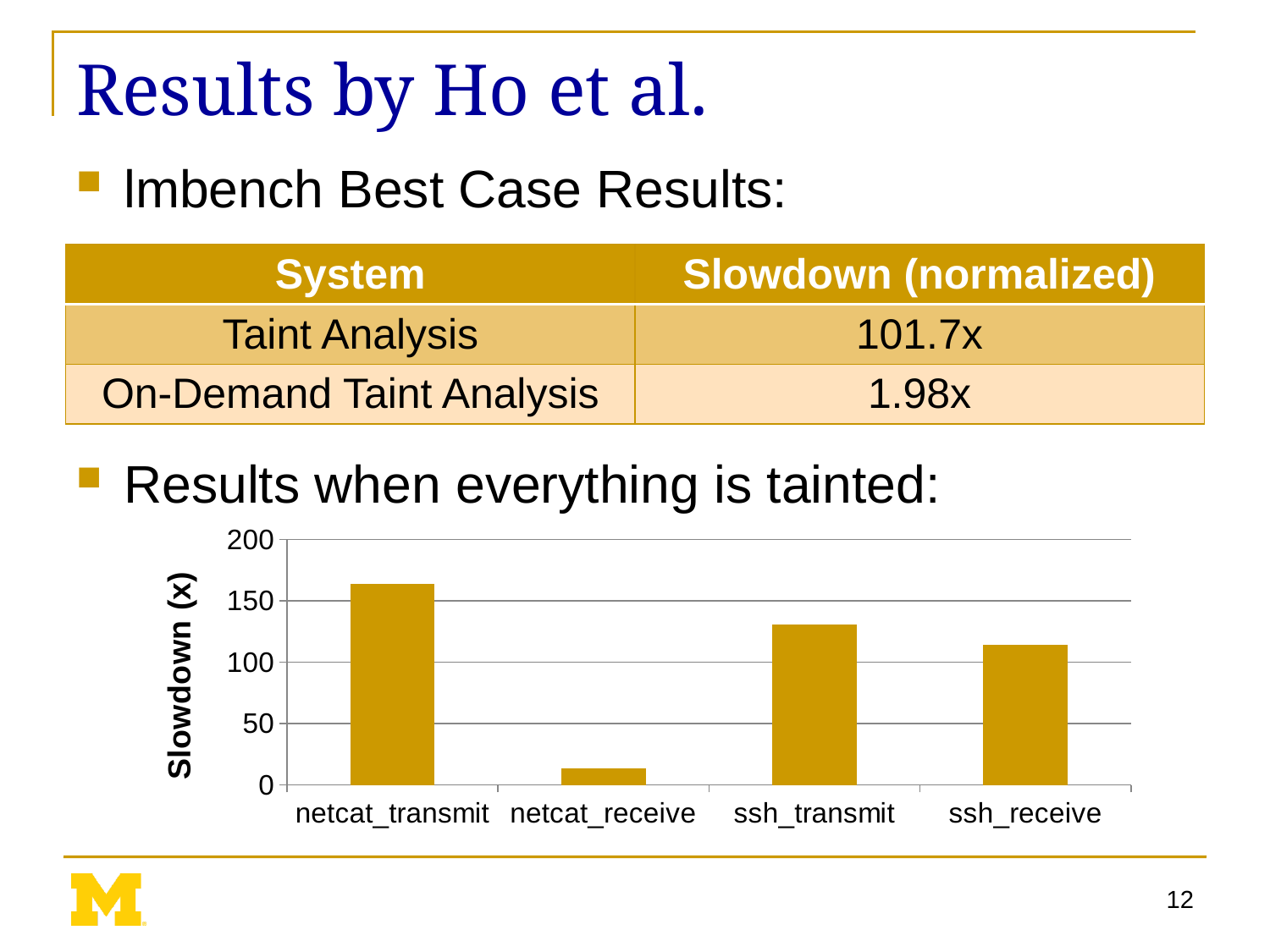
What is the label of the vertical axis of the chart? Slowdown (x) Which has a larger slowdown, netcat_receive or ssh_receive? ssh_receive What kind of chart is shown on the slide? bar chart Which has a larger slowdown, ssh_transmit or ssh_receive? ssh_transmit How many categories are shown on the x axis of the chart? 4 Which category has the highest slowdown in the bar chart? netcat_transmit Is the value for netcat_transmit greater or less than 150? greater Is the value for ssh_transmit greater or less than 100? greater Is the value for ssh_receive greater or less than 150? less What is the maximum value shown on the vertical axis of the chart? 200 Which category has the lowest slowdown in the bar chart? netcat_receive